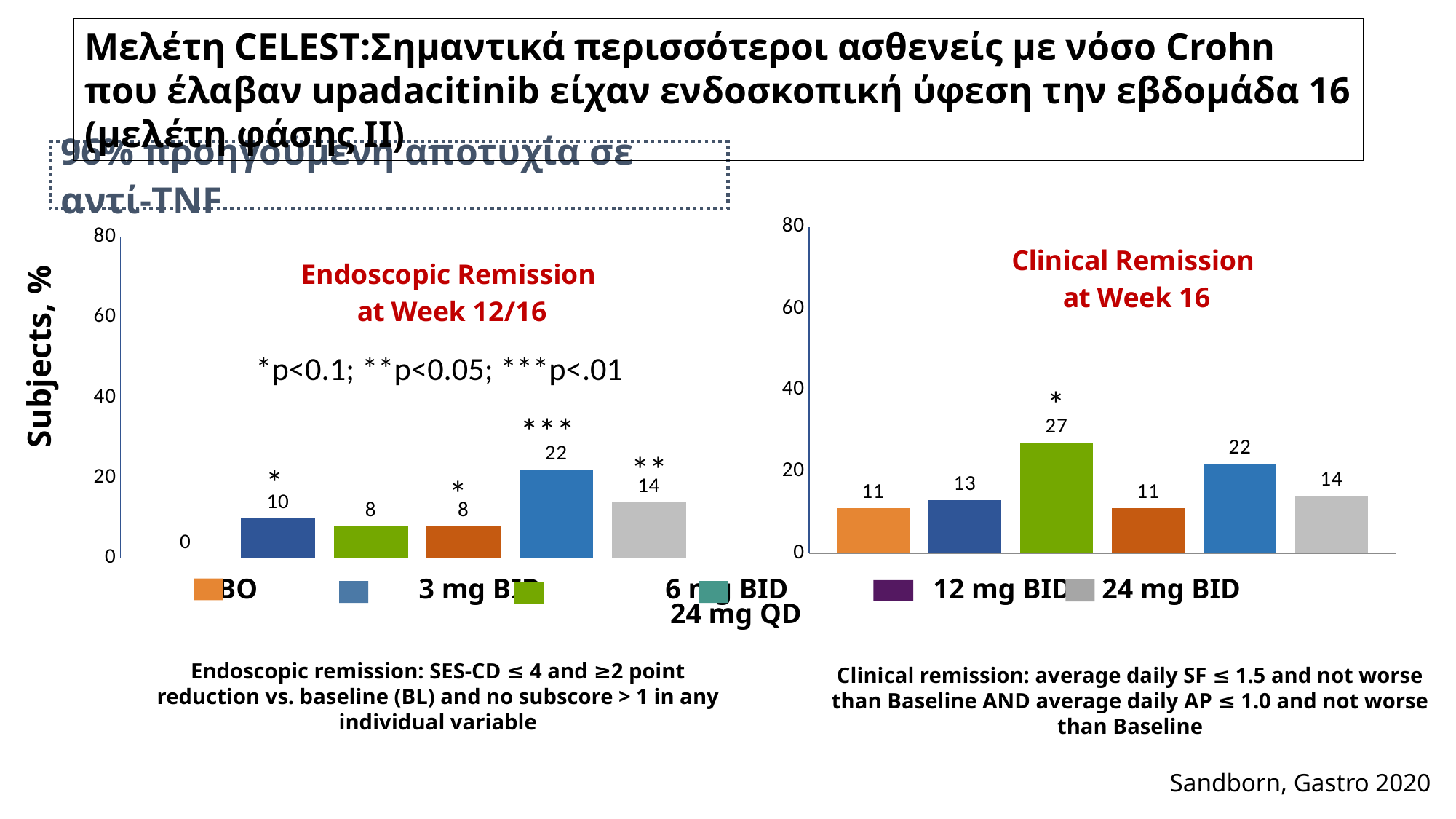
In the 'Clinical Remission at Week 16' chart, what value is labelled on the first (orange) bar? 11 In the 'Endoscopic Remission at Week 12/16' chart, what is the highest value shown on a bar? 22 How many bars are plotted in the 'Clinical Remission at Week 16' chart? 6 In the 'Clinical Remission at Week 16' chart, what is the difference between the green bar (27) and the first orange bar (11)? 16 What kind of chart is the 'Endoscopic Remission at Week 12/16' chart? bar chart In the 'Clinical Remission at Week 16' chart, what is the value of the tallest bar (the green one)? 27 What is the label on the vertical axis of the left chart? Subjects, % What is the maximum value shown on the y axis of the 'Clinical Remission at Week 16' chart? 80 In the 'Endoscopic Remission at Week 12/16' chart, what is the difference between the light blue bar (22) and the gray bar (14)? 8 In the 'Clinical Remission at Week 16' chart, what value is labelled on the gray bar? 14 Which is larger: the green bar in the 'Endoscopic Remission at Week 12/16' chart or the green bar in the 'Clinical Remission at Week 16' chart? the green bar in the Clinical Remission chart In the 'Endoscopic Remission at Week 12/16' chart, what is the value of the lowest bar (the first one)? 0